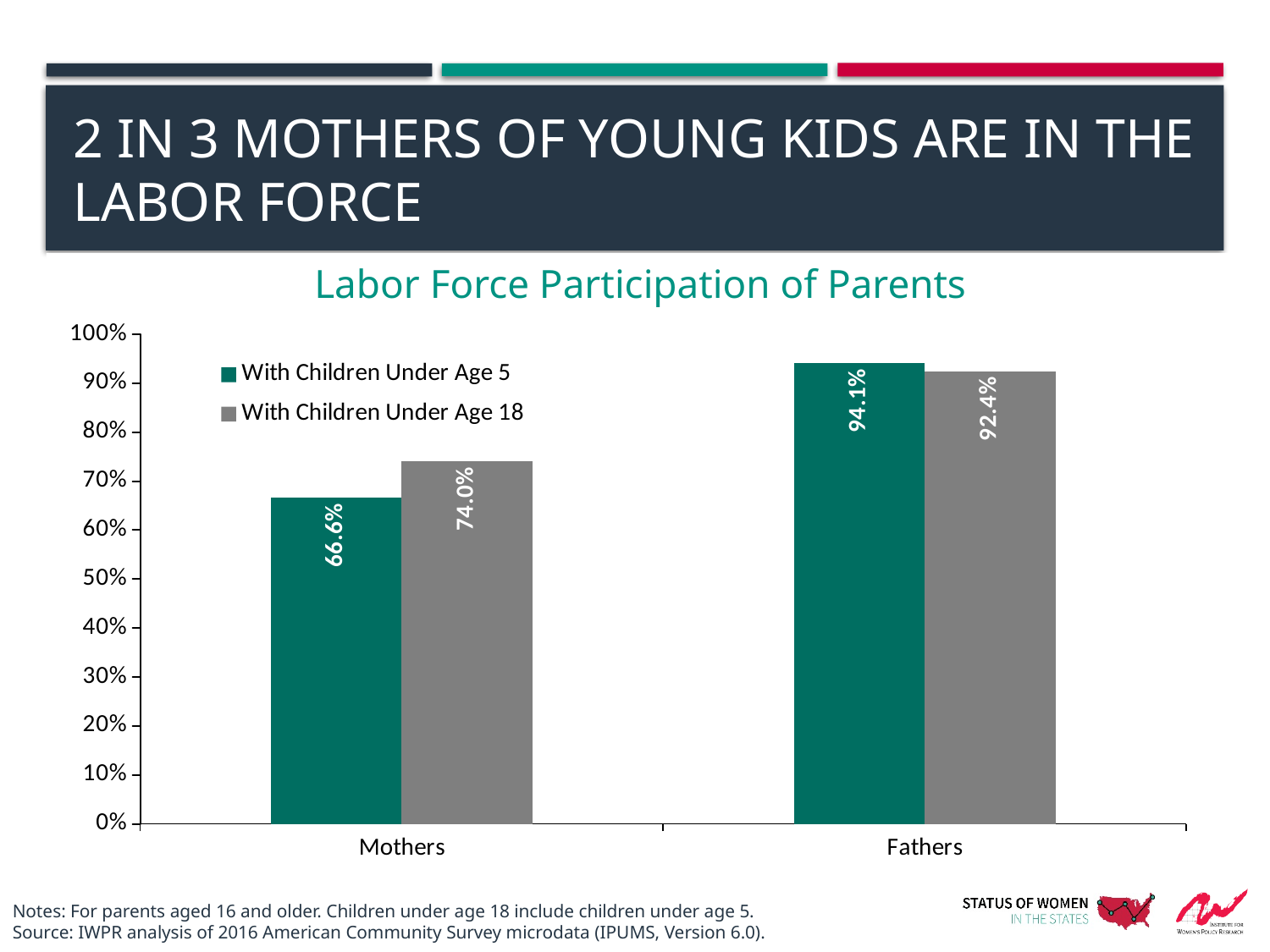
Which category has the lowest value for the 'With Children Under Age 18' series? Mothers How many series does the legend list? 2 What is the difference between the 'With Children Under Age 18' and 'With Children Under Age 5' values for Mothers? 7.4% What is the labor force participation rate for Mothers with children under age 18? 74.0% For Fathers, which is larger: the value for 'With Children Under Age 5' or 'With Children Under Age 18'? With Children Under Age 5 Which category has the highest value for the 'With Children Under Age 5' series? Fathers What type of chart is shown on the slide? Bar chart What is the labor force participation rate for Mothers with children under age 5? 66.6% What is the labor force participation rate for Fathers with children under age 18? 92.4% What is the labor force participation rate for Fathers with children under age 5? 94.1% How many categories are shown on the x axis? 2 What is the difference between the Fathers and Mothers values for the 'With Children Under Age 5' series? 27.5%